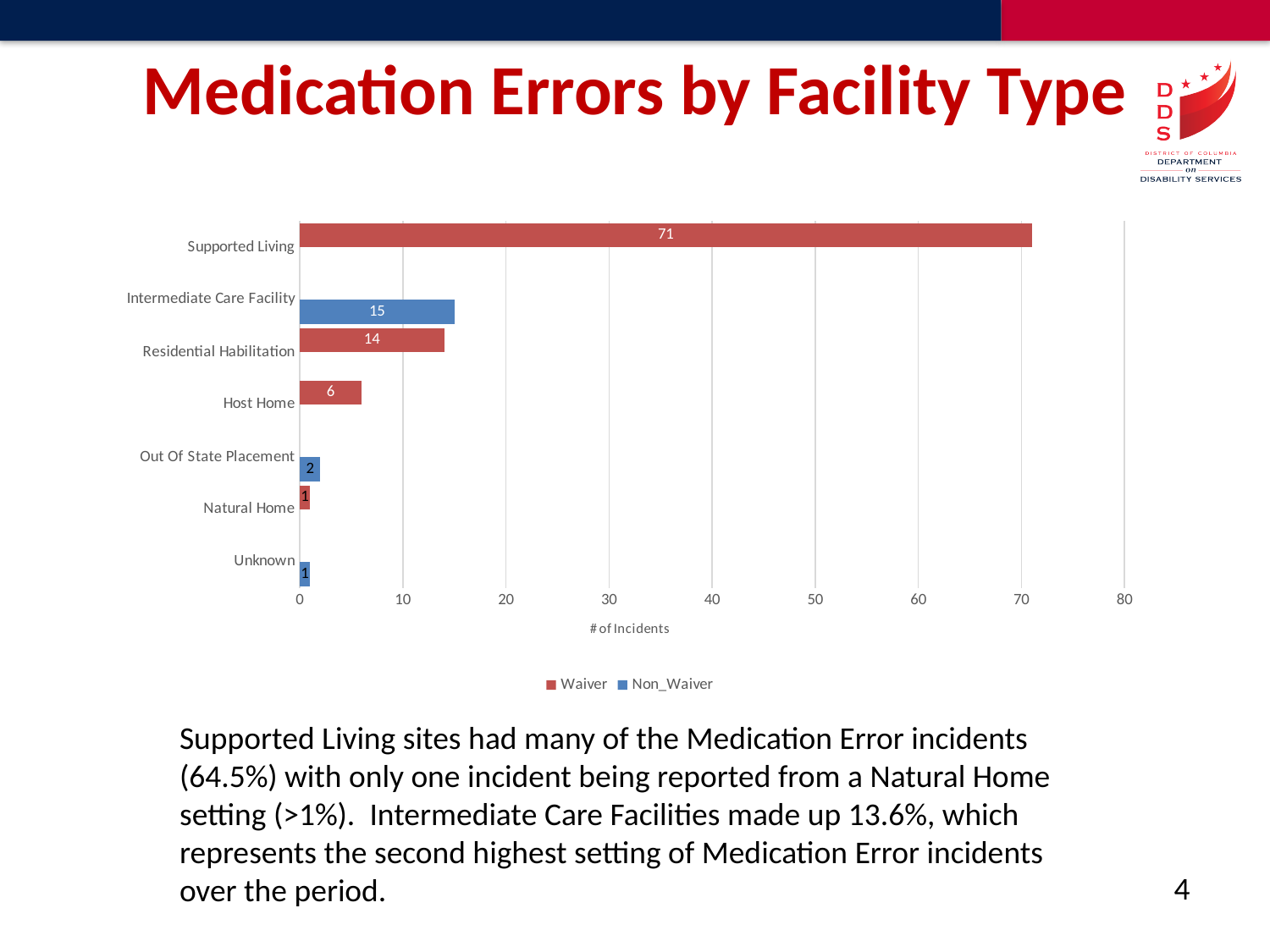
How many incidents are shown for Host Home? 6 How many series does the legend list? 2 How many incidents are shown for Residential Habilitation? 14 What is the difference in incidents between Supported Living and Intermediate Care Facility? 56 What kind of chart is shown on the slide? Bar chart How many incidents are shown for Supported Living? 71 How many incidents are shown for Intermediate Care Facility? 15 What is the label of the horizontal axis? # of Incidents Which has more incidents, Host Home or Out Of State Placement? Host Home How many facility types are listed on the chart? 7 Is the value for Supported Living greater or less than 70? greater Which facility type has the highest number of incidents? Supported Living